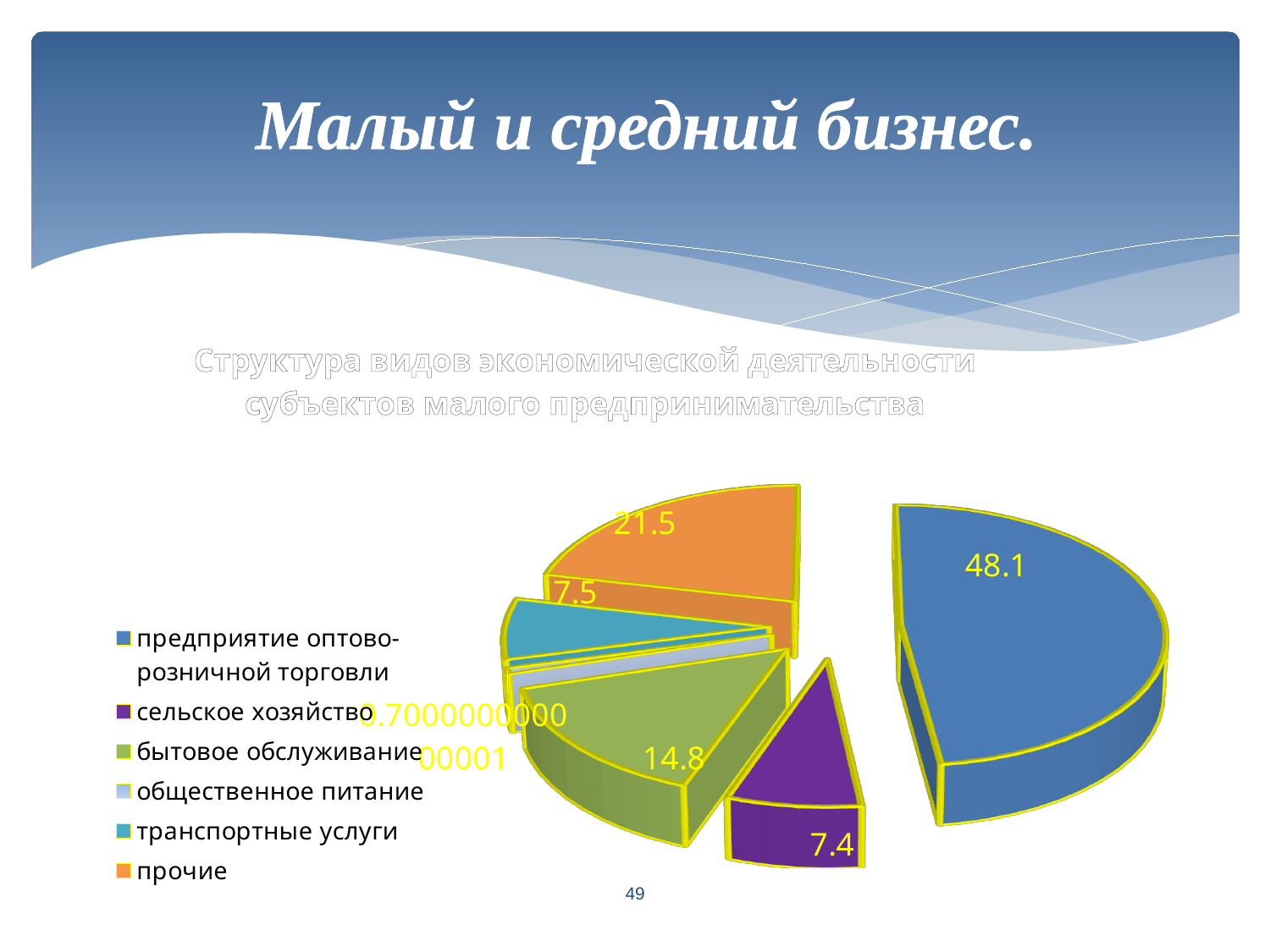
What is the value for транспортные услуги? 7.5 What kind of chart is shown on the slide? pie chart What is the value for бытовое обслуживание? 14.8 Which category has the largest slice of the pie? предприятие оптово-розничной торговли Which category has the smallest slice of the pie? общественное питание How many categories does the pie chart show? 6 What is the value for прочие? 21.5 What is the title of the chart? Структура видов экономической деятельности субъектов малого предпринимательства What is the value for предприятие оптово-розничной торговли? 48.1 What is the value for сельское хозяйство? 7.4 What is the difference between the values for предприятие оптово-розничной торговли and прочие? 26.6 Which is larger, the value for прочие or the value for бытовое обслуживание? прочие